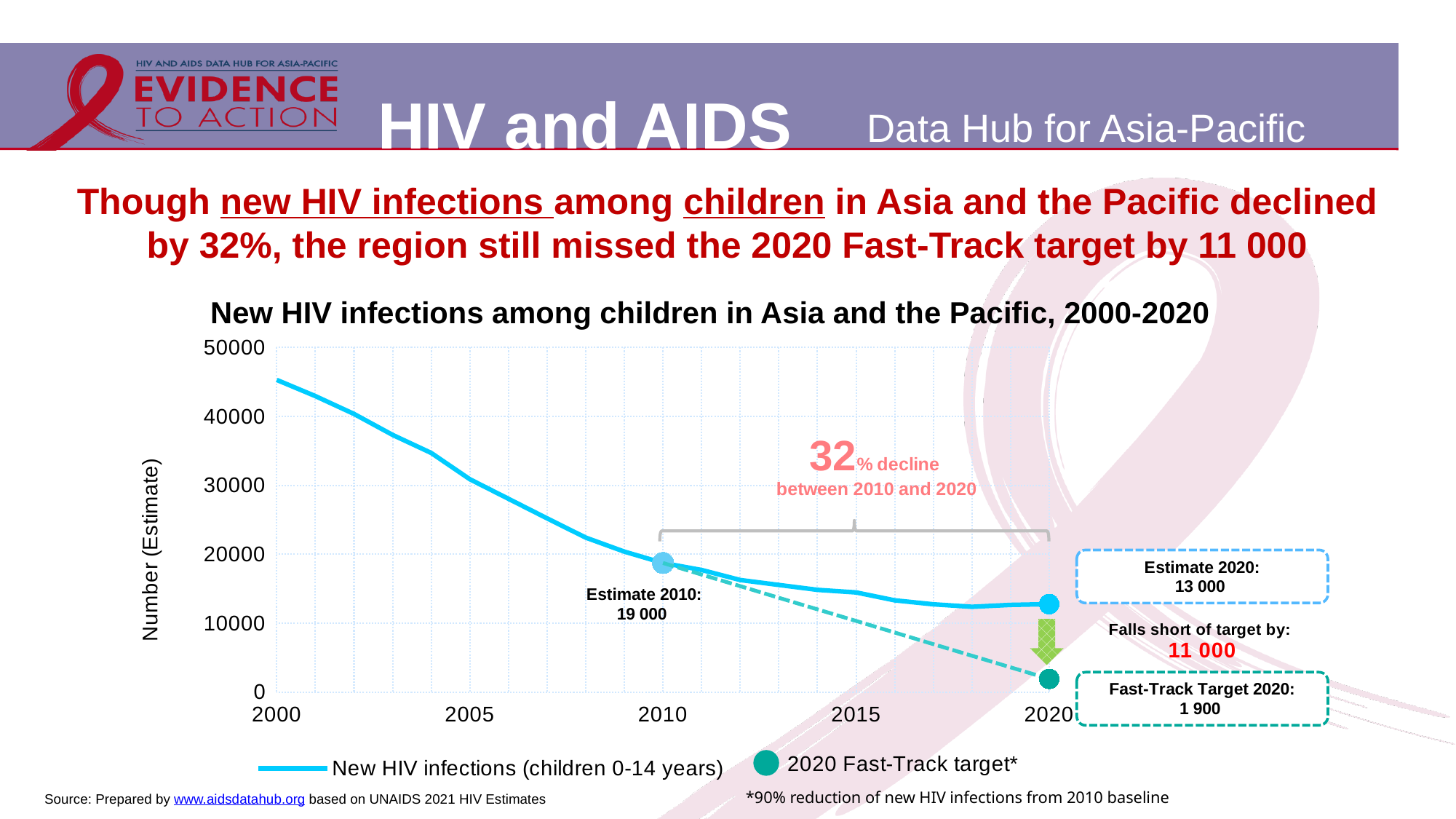
Do new HIV infections among children rise or fall from 2000 to 2020? fall What is the difference between the 2010 estimate and the 2020 estimate of new HIV infections among children? 6 000 What is the estimated number of new HIV infections among children in 2020? 13 000 How many entries does the chart legend list? 2 What kind of chart is used to show new HIV infections among children in Asia and the Pacific? line chart Which is larger, the 2020 estimate or the 2020 Fast-Track target? 2020 estimate What percentage decline in new HIV infections among children occurred between 2010 and 2020? 32% By how much did the region fall short of the 2020 Fast-Track target, according to the chart annotation? 11 000 Is the value for new HIV infections among children in 2015 greater or less than 20000? less What is the estimated number of new HIV infections among children in 2010? 19 000 Is the value for new HIV infections among children in 2000 greater or less than 40000? greater What is the 2020 Fast-Track target for new HIV infections among children? 1 900